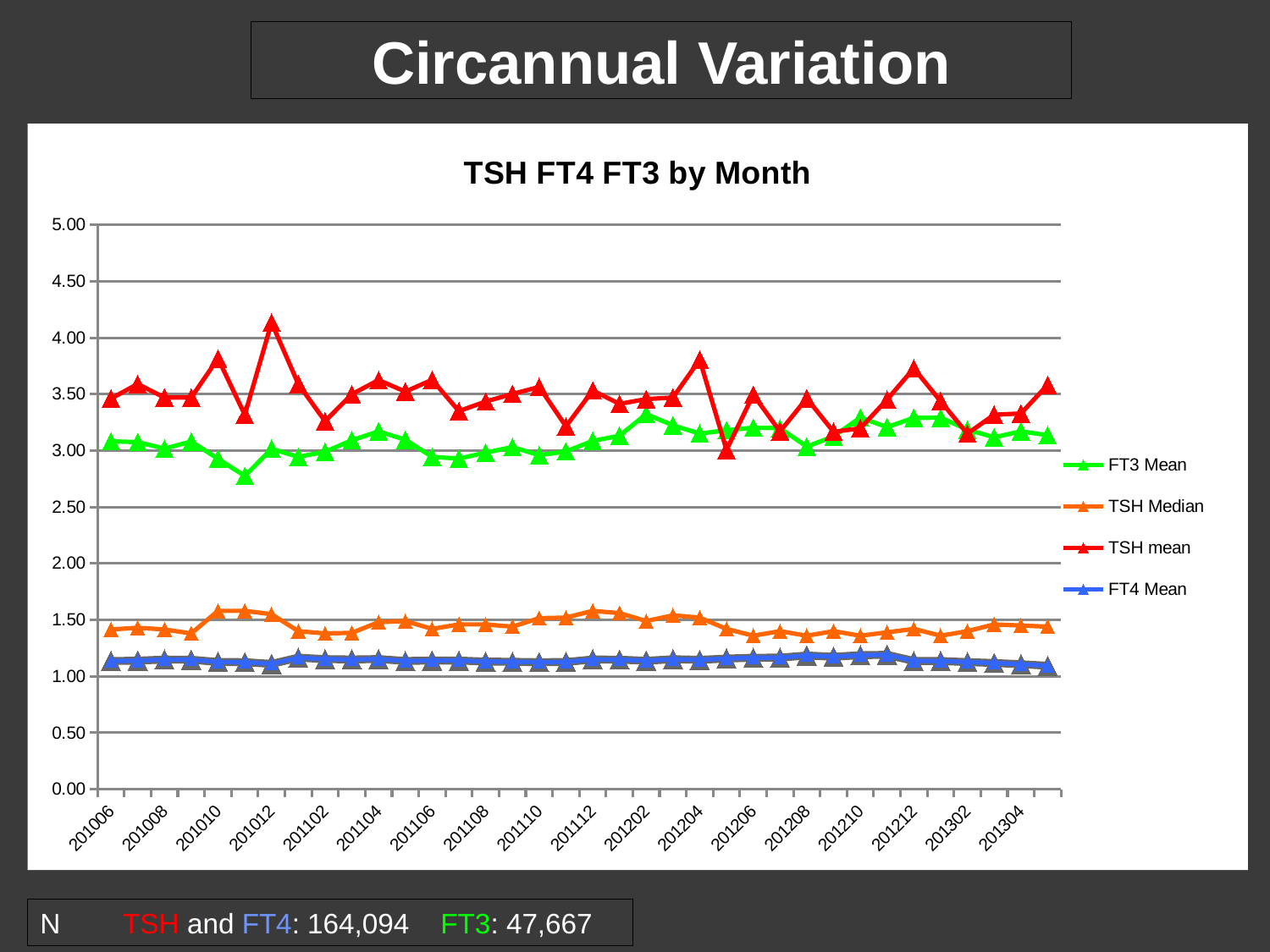
At 201006, which is larger: TSH mean or FT3 Mean? TSH mean Which series has the lowest values across the chart? FT4 Mean What kind of chart is shown on the slide? Line chart How many series does the legend list? 4 Is the peak value of TSH mean near 201011 greater or less than 4.00? greater At 201304, which is larger: TSH Median or FT4 Mean? TSH Median Which series has the highest values across the chart? TSH mean Is the value of TSH Median at 201010 greater or less than 2.00? less Which colour is used for the TSH mean series? Red Is the value of FT3 Mean at 201202 greater or less than 3.00? greater What is the title of the chart? TSH FT4 FT3 by Month